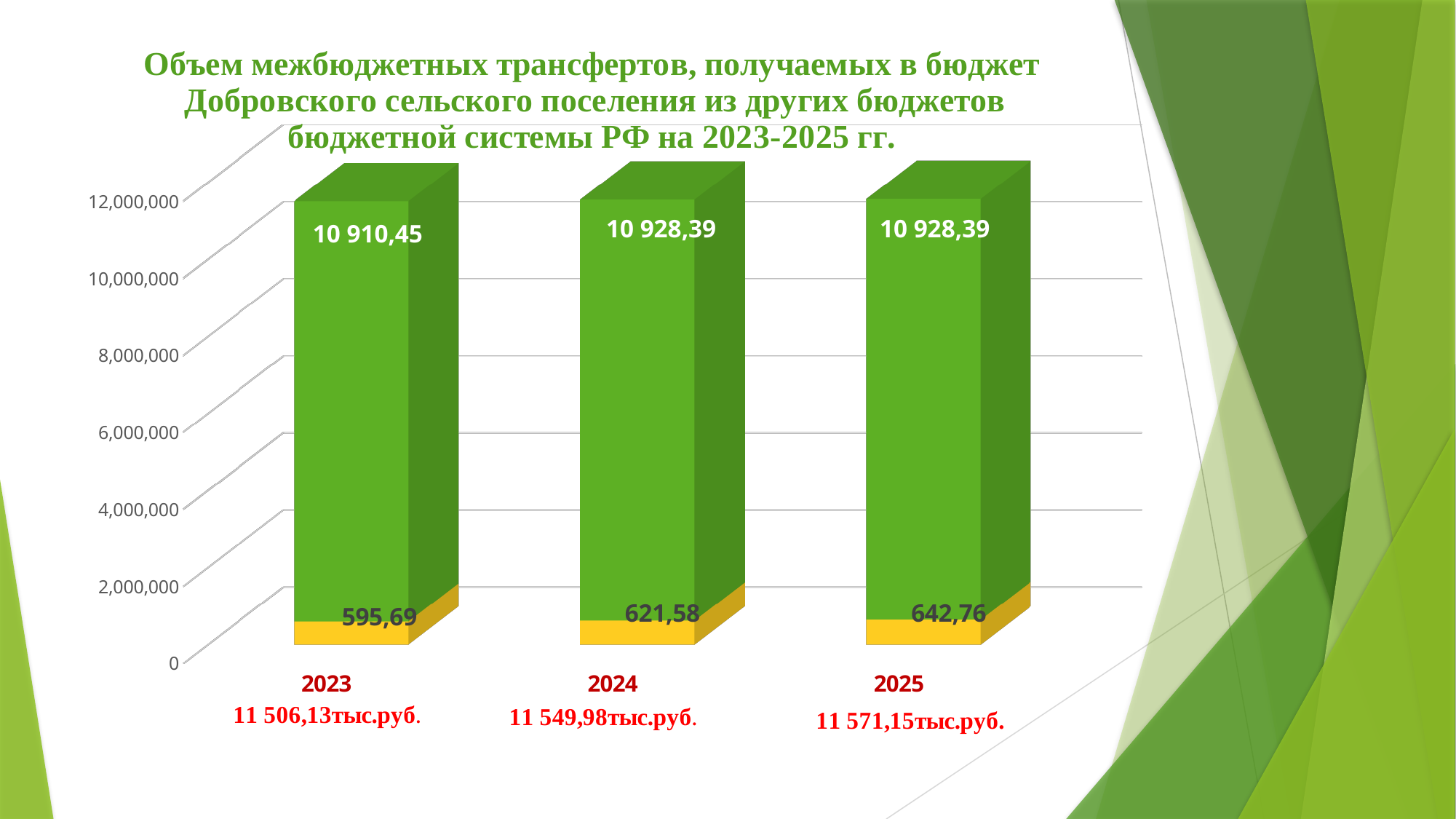
Do the yellow segment values rise or fall from 2023 to 2025? rise Which is larger, the yellow segment value for 2023 or for 2024? 2024 Which year has the lowest value for the green segment? 2023 What is the value printed on the green segment of the 2023 bar? 10 910,45 What is the value printed on the green segment of the 2025 bar? 10 928,39 How many years are shown on the x axis? 3 What total is printed under the 2025 bar? 11 571,15тыс.руб. What kind of chart is shown on the slide? stacked bar chart Which year has the highest value for the yellow segment? 2025 Is the total height of the 2023 bar greater or less than 10,000,000 on the axis? greater What is the difference between the yellow segment values for 2025 and 2023? 47,07 What is the value printed on the yellow segment of the 2024 bar? 621,58